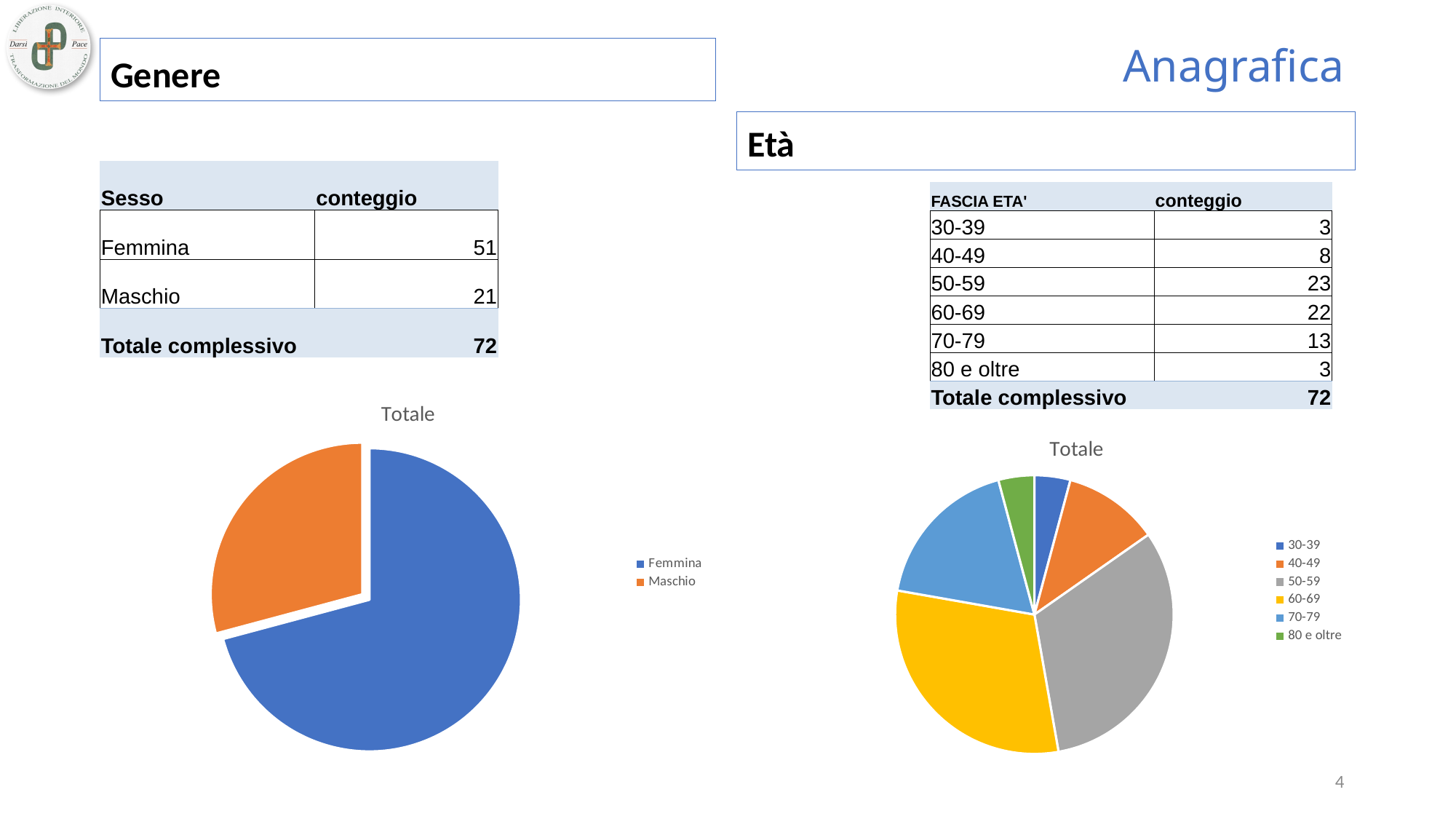
In the Genere pie chart on the left, what is the count for Femmina? 51 How many age bands does the legend of the Età pie chart on the right list? 6 In the Età pie chart on the right, what is the count for the 50-59 age band? 23 How many entries does the legend of the Genere pie chart on the left list? 2 What is the title shown above the Età pie chart on the right? Totale In the Età pie chart on the right, what is the difference between the counts for 60-69 and 70-79? 9 In the Genere pie chart on the left, what is the difference between the Femmina and Maschio counts? 30 In the Genere pie chart on the left, which category has the larger slice? Femmina In the Età pie chart on the right, is the slice for 70-79 larger or smaller than the slice for 40-49? larger What type of chart is shown under the Genere heading on the left of the slide? pie chart In the Genere pie chart on the left, what is the count for Maschio? 21 In the Età pie chart on the right, which age band has the largest slice? 50-59